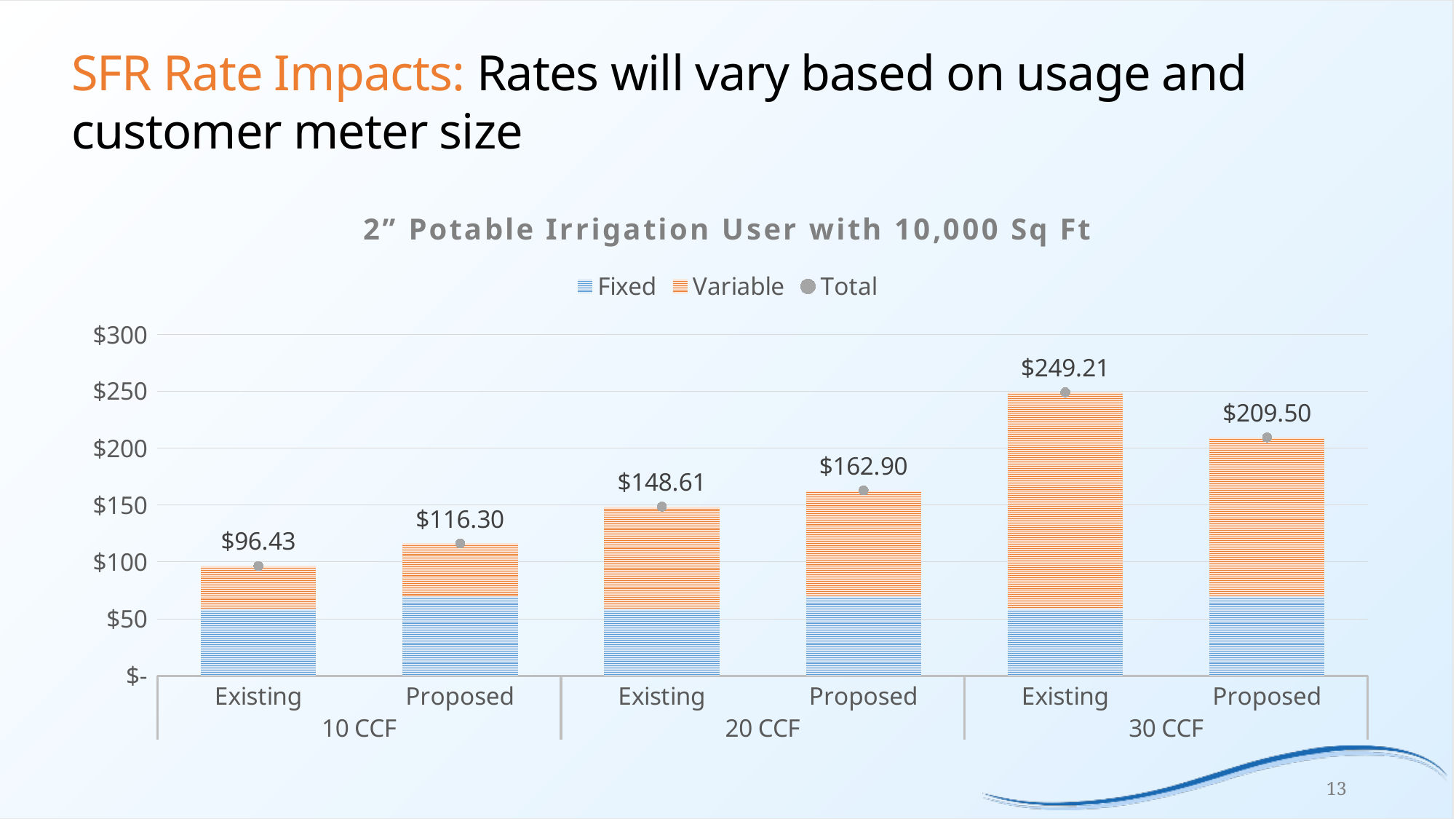
What is the difference between the Proposed and Existing Totals at 10 CCF? $19.87 Which bar has the highest Total? Existing, 30 CCF What is the difference between the Existing and Proposed Totals at 30 CCF? $39.71 What is the Total for the Existing bar at 10 CCF? $96.43 Which bar has the lowest Total? Existing, 10 CCF At 20 CCF, which is larger, the Existing Total or the Proposed Total? Proposed What is the Total for the Proposed bar at 20 CCF? $162.90 How many series does the legend list? 3 Is the Fixed portion of the Existing bar at 10 CCF greater or less than $100? less What kind of chart is shown on the slide? Stacked bar chart How many bars are plotted in the chart? 6 What is the Total for the Proposed bar at 30 CCF? $209.50